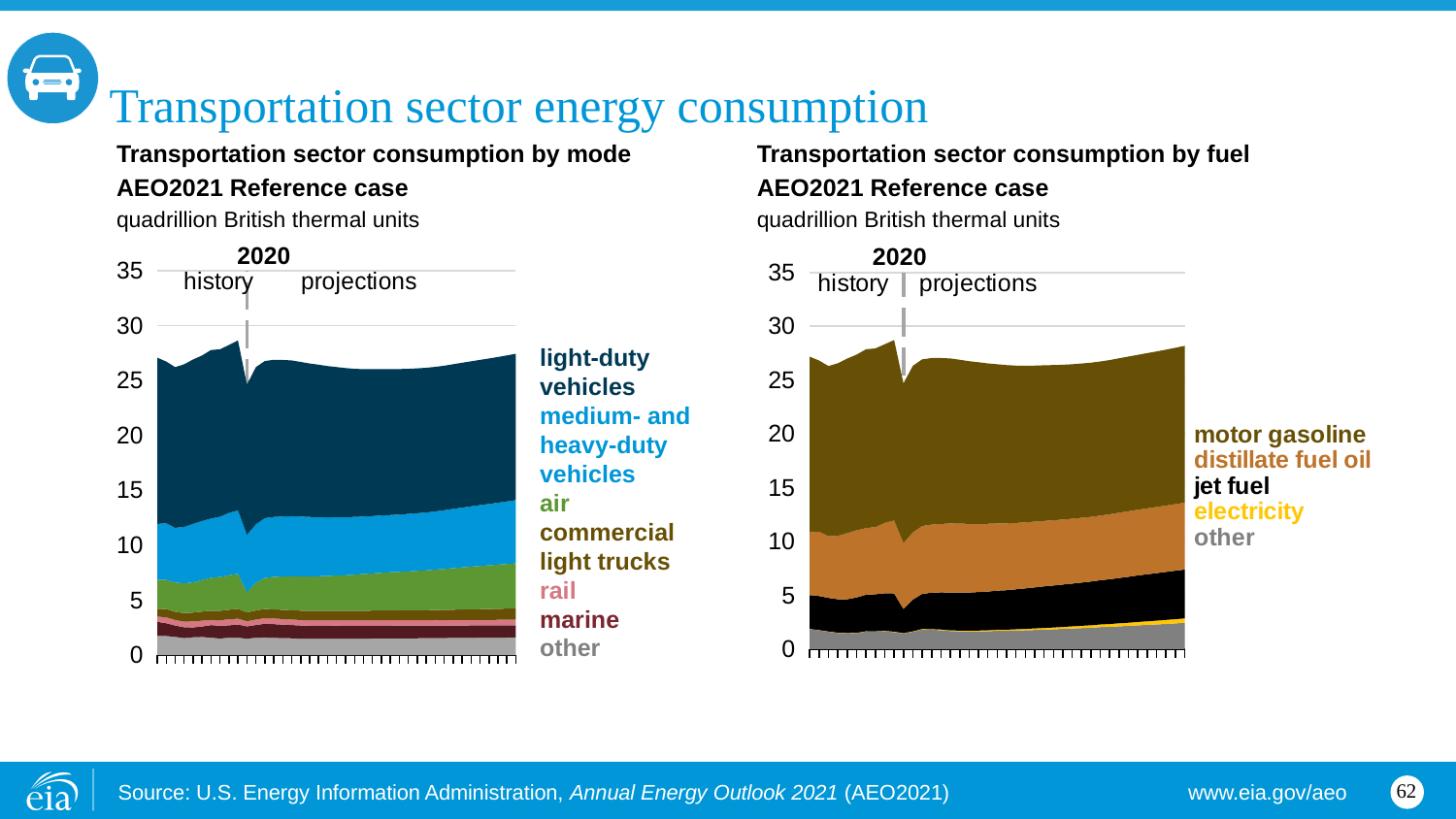
What unit of measurement is used on both charts? quadrillion British thermal units In the left chart, 'Transportation sector consumption by mode', is the total consumption at the end of the projection period greater or less than 25? greater What year marks the boundary between history and projections on the charts? 2020 In the left chart, 'Transportation sector consumption by mode', which mode accounts for the largest share of consumption? light-duty vehicles How many series does the legend of the left chart, 'Transportation sector consumption by mode', list? 7 In the left chart, 'Transportation sector consumption by mode', is light-duty vehicles consumption larger than air consumption? yes In the right chart, 'Transportation sector consumption by fuel', which fuel accounts for the largest share of consumption? motor gasoline In the right chart, 'Transportation sector consumption by fuel', is the total consumption at the end of the projection period greater or less than 30? less In the right chart, 'Transportation sector consumption by fuel', which is larger, distillate fuel oil or jet fuel? distillate fuel oil How many series does the legend of the right chart, 'Transportation sector consumption by fuel', list? 5 What kind of chart is the 'Transportation sector consumption by mode' chart on the left? stacked area chart In the right chart, 'Transportation sector consumption by fuel', which fuel accounts for the smallest share of consumption? electricity